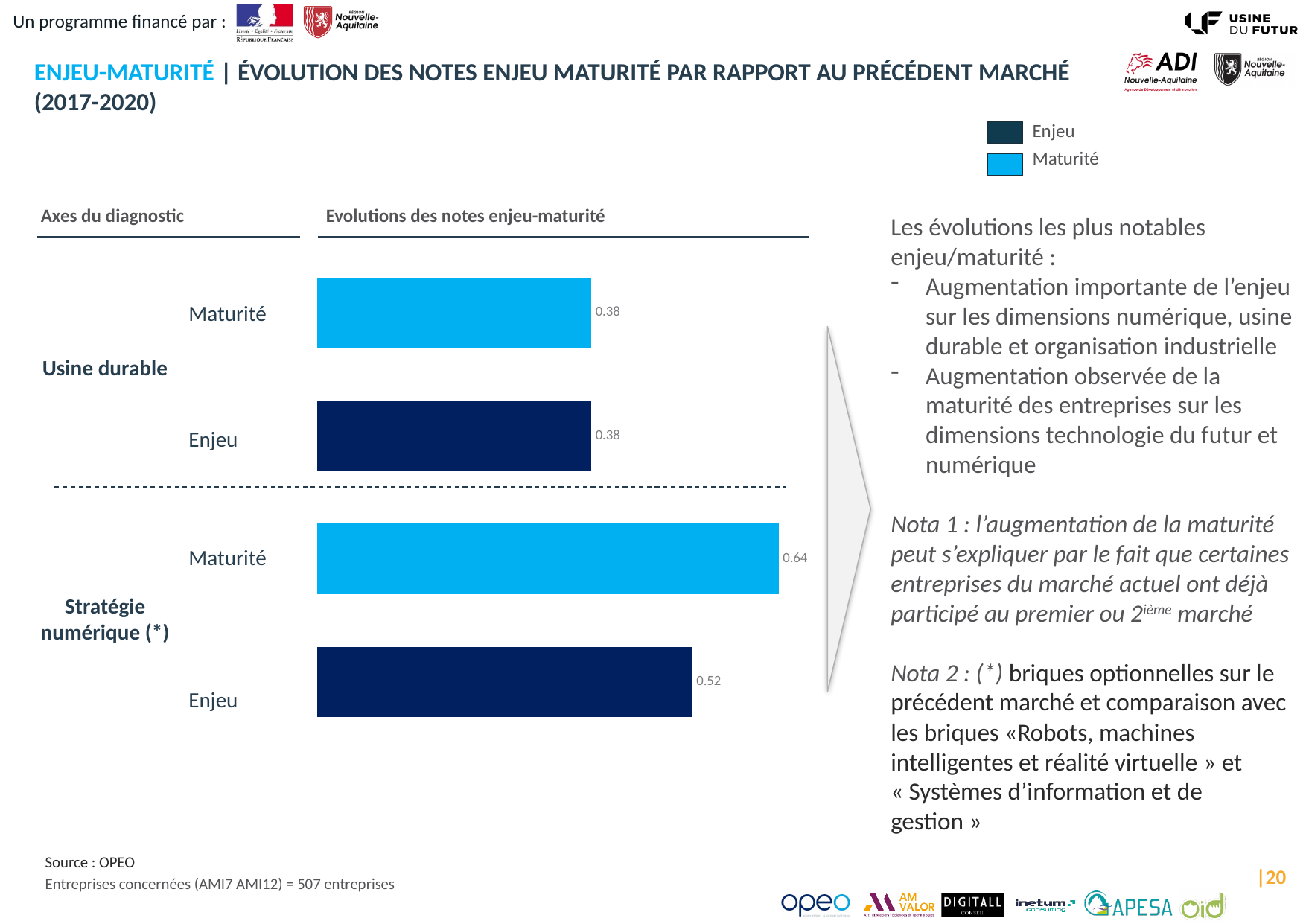
What is the Enjeu value for Usine durable? 0.38 What is the Maturité value for Usine durable? 0.38 What is the difference between the Maturité values for Stratégie numérique (*) and Usine durable? 0.26 What kind of chart is shown on the slide? Bar chart What is the Enjeu value for Stratégie numérique (*)? 0.52 Which is larger: the Enjeu value for Stratégie numérique (*) or the Enjeu value for Usine durable? Stratégie numérique (*) Which series is shown in light blue according to the legend? Maturité Which bar has the highest value on the chart? Maturité for Stratégie numérique (*) What is the Maturité value for Stratégie numérique (*)? 0.64 How many series does the legend list? 2 How many bars are plotted on the chart? 4 What is the difference between the Maturité and Enjeu values for Stratégie numérique (*)? 0.12